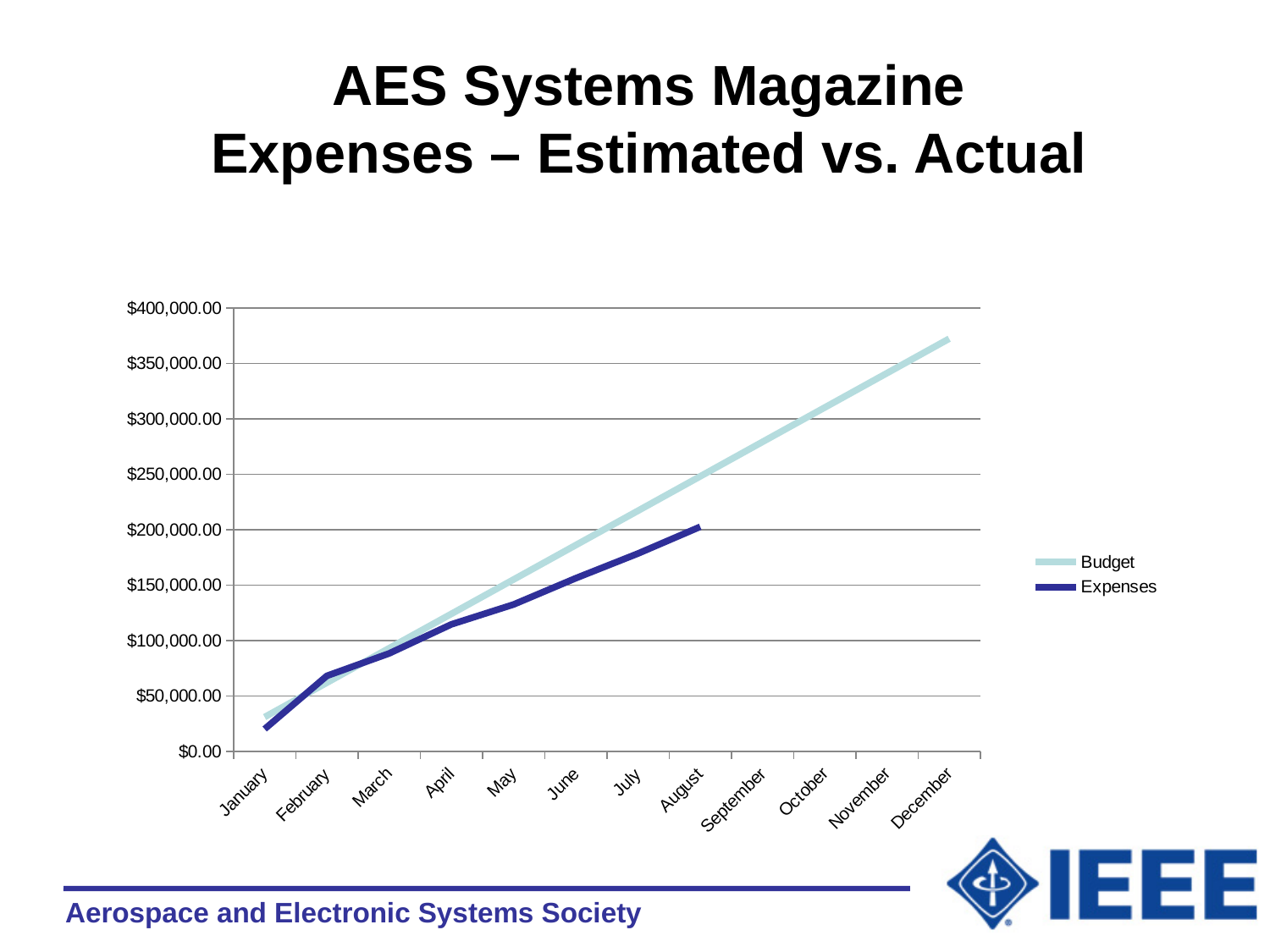
Is the Budget value for September greater or less than $300,000.00? less Which series is drawn in the dark blue line? Expenses How many series does the legend list? 2 Does the Expenses line rise or fall from January to August? Rises How many months are shown along the x axis? 12 In August, which series has the higher value, Budget or Expenses? Budget Is the Expenses value for January greater or less than $50,000.00? less What is the last month for which the Expenses line has a data point? August Does the Budget line rise or fall from January to December? Rises Is the Expenses value for August greater or less than $150,000.00? greater What kind of chart is shown on the slide? Line chart